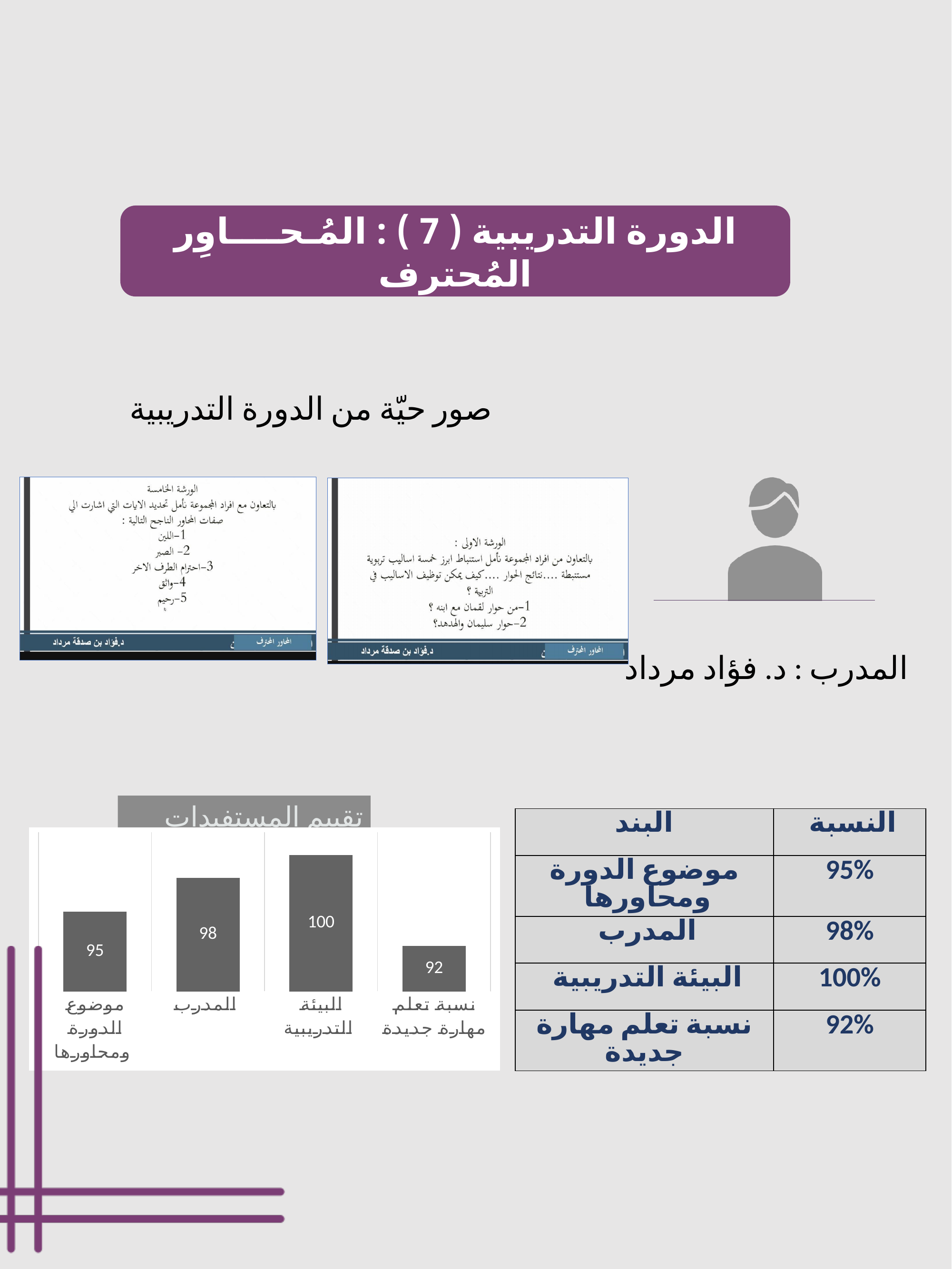
In the bar chart, what is the difference between the values for المدرب and موضوع الدورة ومحاورها? 3 In the bar chart, which is larger: the value for المدرب or the value for موضوع الدورة ومحاورها? المدرب In the bar chart, what is the value for البيئة التدريبية? 100 What is the title of the bar chart? تقييم المستفيدات In the bar chart, what is the value for نسبة تعلم مهارة جديدة? 92 Which category has the lowest value in the bar chart? نسبة تعلم مهارة جديدة What kind of chart is shown at the bottom left of the slide? Bar chart In the bar chart, what is the value for موضوع الدورة ومحاورها? 95 In the bar chart, what is the difference between the values for البيئة التدريبية and نسبة تعلم مهارة جديدة? 8 How many categories are shown in the bar chart? 4 In the bar chart, what is the value for المدرب? 98 Which category has the highest value in the bar chart? البيئة التدريبية